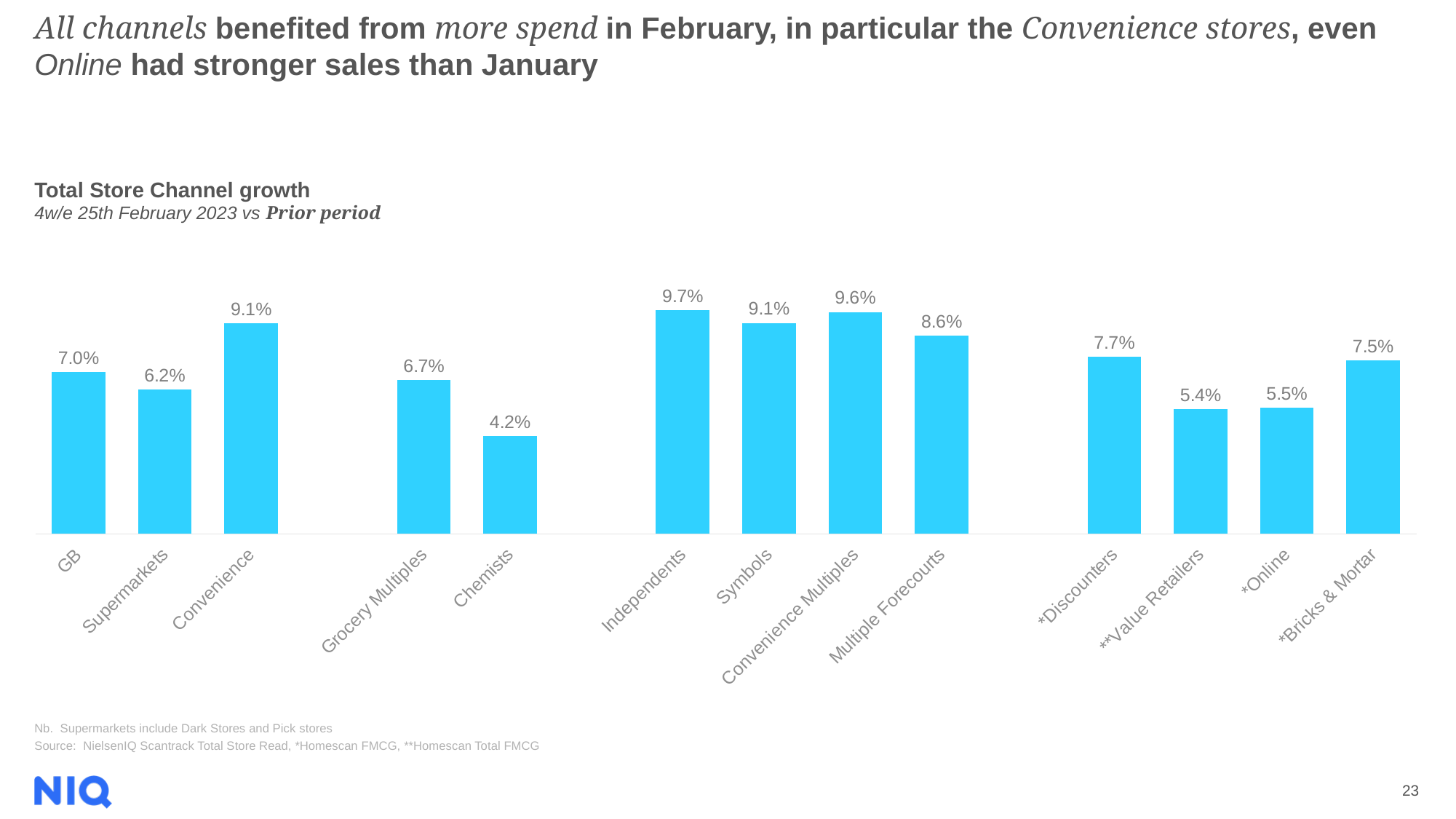
What is the title of the chart? Total Store Channel growth Which has a higher growth value, Supermarkets or Grocery Multiples? Grocery Multiples What is the difference between the growth values for *Discounters and **Value Retailers? 2.3% What is the growth value for *Online? 5.5% How many categories are shown in the chart? 13 What is the growth value for Chemists? 4.2% What is the growth value for Multiple Forecourts? 8.6% What is the growth value for Convenience? 9.1% What kind of chart is shown on the slide? Bar chart Which category has the highest growth value? Independents What is the difference between the growth values for Independents and GB? 2.7% Which category has the lowest growth value? Chemists